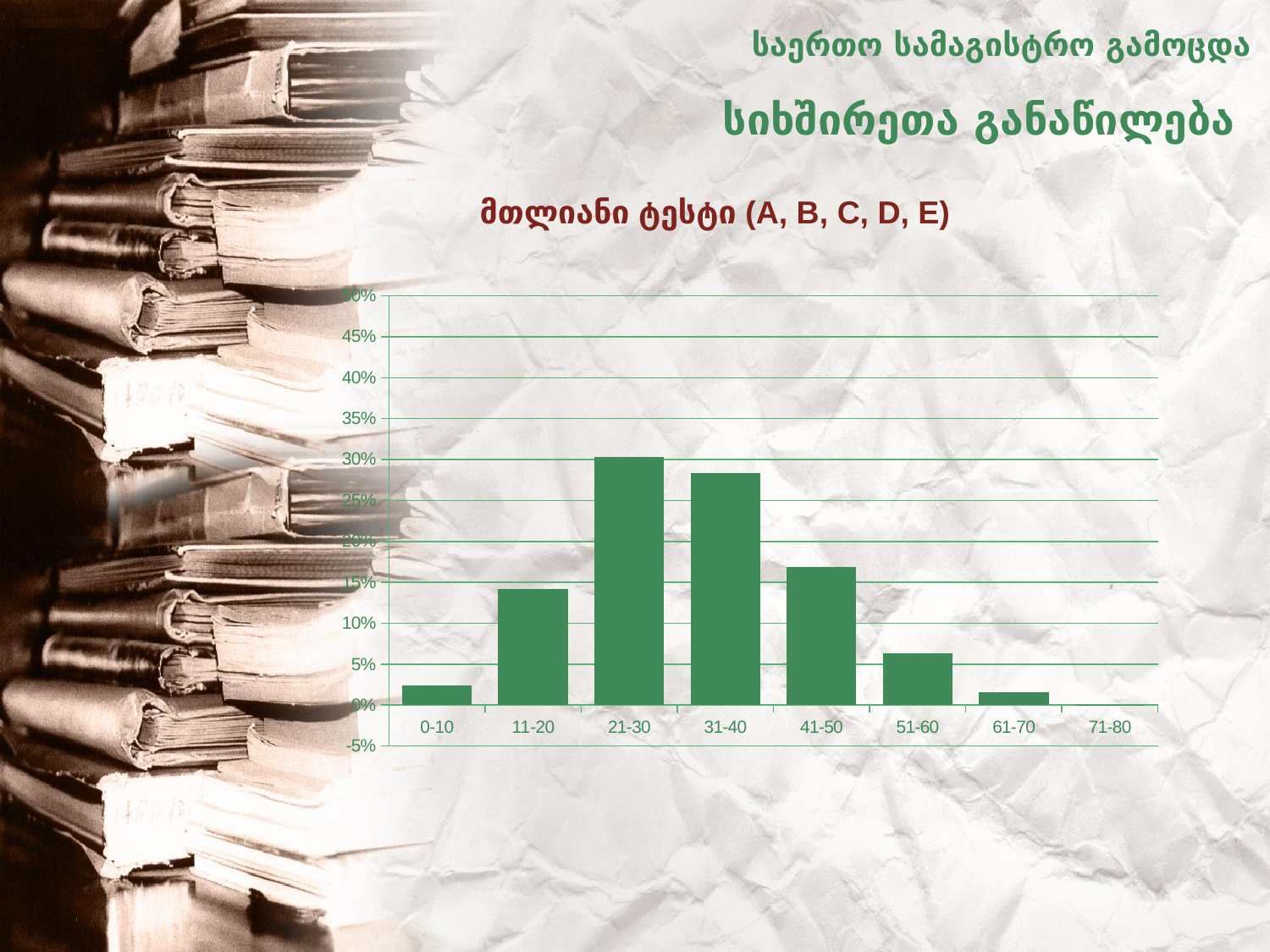
What is the title of the chart? მთლიანი ტესტი (A, B, C, D, E) Is the value for 11-20 greater or less than 15%? less Is the value for 0-10 greater or less than 5%? less Is the value for 41-50 greater or less than 15%? greater Which category has the larger value, 51-60 or 0-10? 51-60 Which category has the highest bar in the chart? 21-30 Which category has the lowest value in the chart? 71-80 Which category has the larger value, 11-20 or 41-50? 41-50 How many score-range categories are shown on the x axis of the chart? 8 What kind of chart is shown on the slide? bar chart